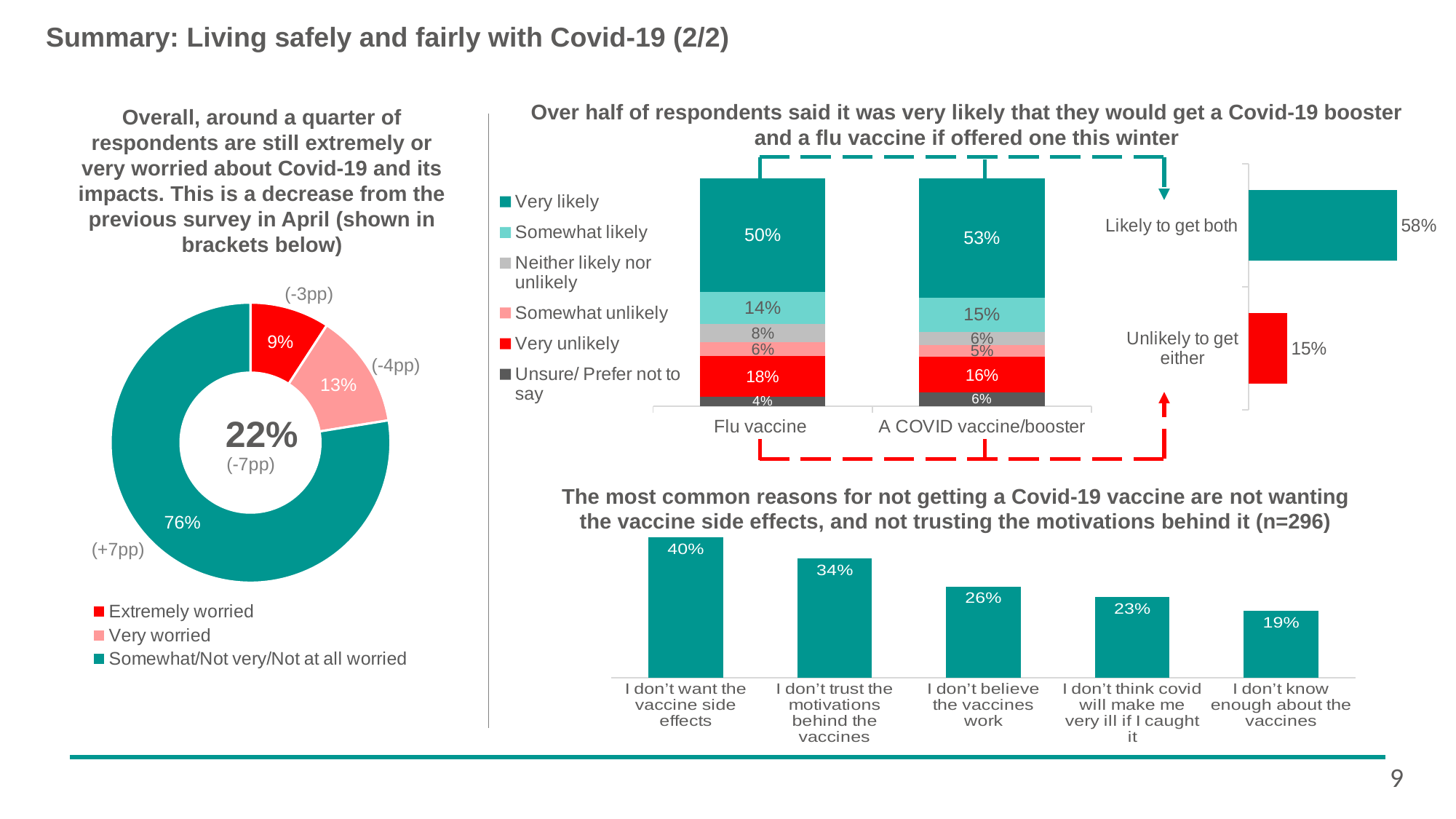
In the stacked bar chart about getting a Covid-19 booster and a flu vaccine, how many series does the legend list? 6 In the small bar chart on the right, what percentage are likely to get both vaccines? 58% In the bottom chart about reasons for not getting a Covid-19 vaccine, how many reasons are shown? 5 In the stacked bar chart about getting a Covid-19 booster and a flu vaccine, what percentage said they were very unlikely to get a COVID vaccine/booster? 16% In the donut chart on the left, what share of respondents are extremely worried? 9% In the bottom chart about reasons for not getting a Covid-19 vaccine, which reason has the lowest value? I don't know enough about the vaccines In the stacked bar chart about getting a Covid-19 booster and a flu vaccine, what is the difference between the 'Very likely' values for the COVID vaccine/booster and the flu vaccine? 3 percentage points In the stacked bar chart about getting a Covid-19 booster and a flu vaccine, what percentage said they were very likely to get a flu vaccine? 50% In the donut chart on the left, which category has the largest share? Somewhat/Not very/Not at all worried In the donut chart on the left, what share of respondents are very worried? 13% In the bottom chart about reasons for not getting a Covid-19 vaccine, what percentage said 'I don't trust the motivations behind the vaccines'? 34% In the small bar chart on the right, what percentage are unlikely to get either vaccine? 15%